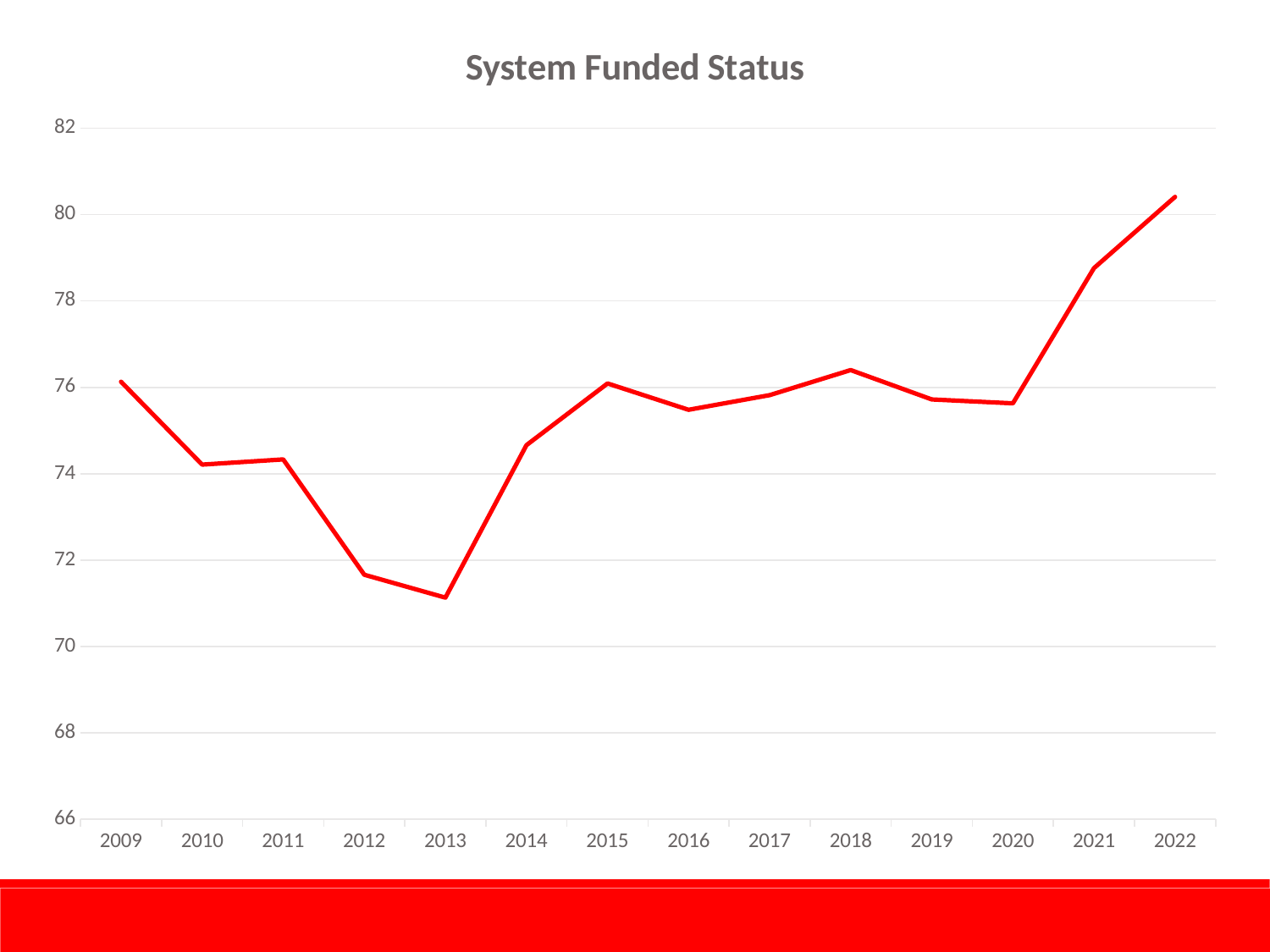
What is the title of the chart? System Funded Status What kind of chart is shown on the slide? line chart Is the value for 2014 greater or less than 74? greater Do the values rise or fall from 2009 to 2013? fall Is the value for 2022 greater or less than 80? greater How many years are plotted on the x axis? 14 Which year has the lowest funded status? 2013 Which year has the highest funded status? 2022 Which is larger, the value for 2013 or the value for 2014? 2014 Which is larger, the value for 2009 or the value for 2022? 2022 Is the value for 2021 greater or less than 78? greater